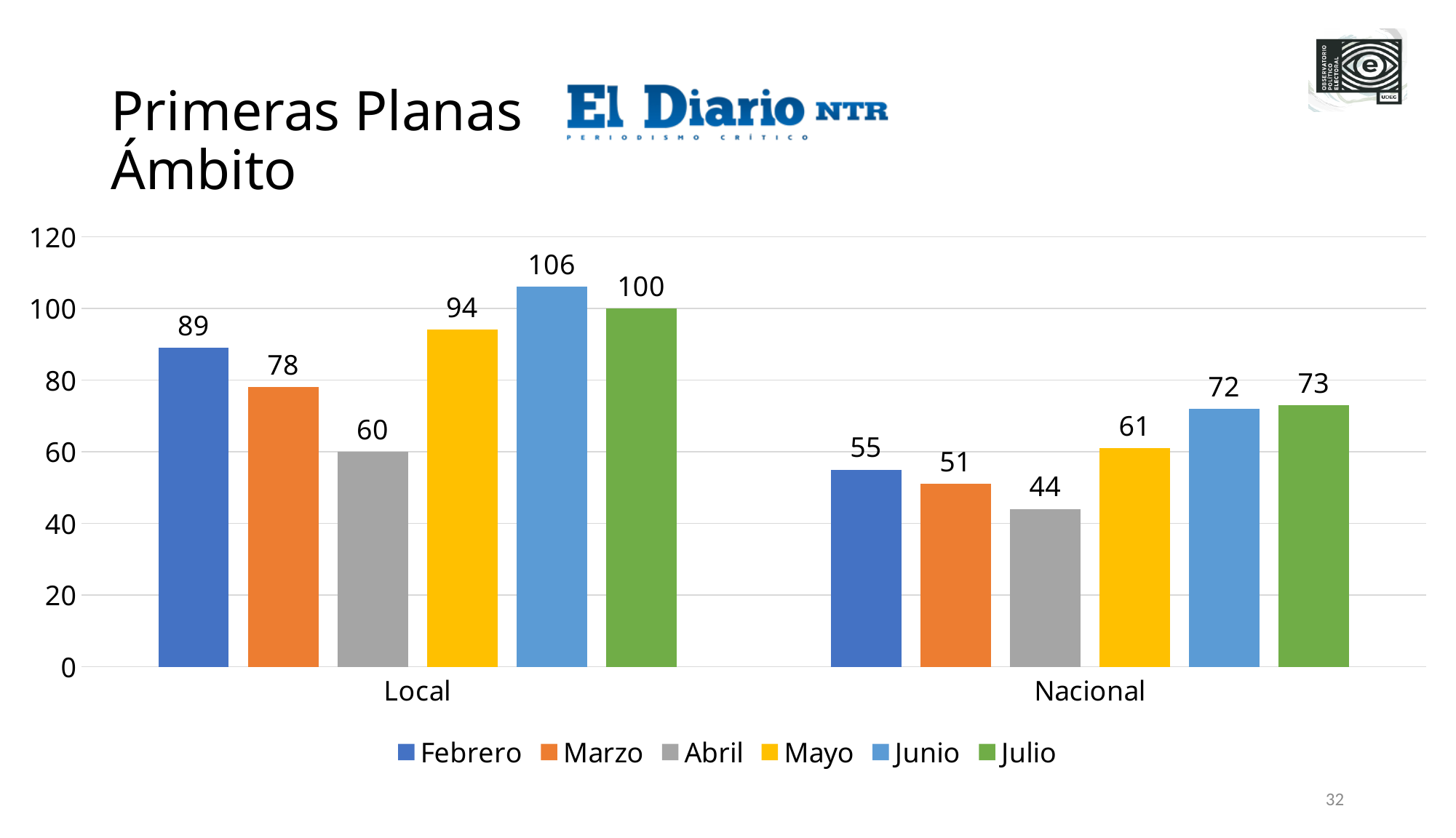
Which is larger, the Febrero value for Local or the Febrero value for Nacional? Local What is the value for Abril in the Nacional category? 44 Which month has the highest value in the Local category? Junio How many categories are shown on the x axis? 2 What is the difference between the Julio values for Local and Nacional? 27 Which colour represents Mayo in the legend? Yellow Which month has the lowest value in the Nacional category? Abril How many series does the legend list? 6 What is the difference between the Junio and Marzo values in the Local category? 28 What is the value for Mayo in the Local category? 94 What is the value for Junio in the Local category? 106 What kind of chart is shown on the slide? Bar chart